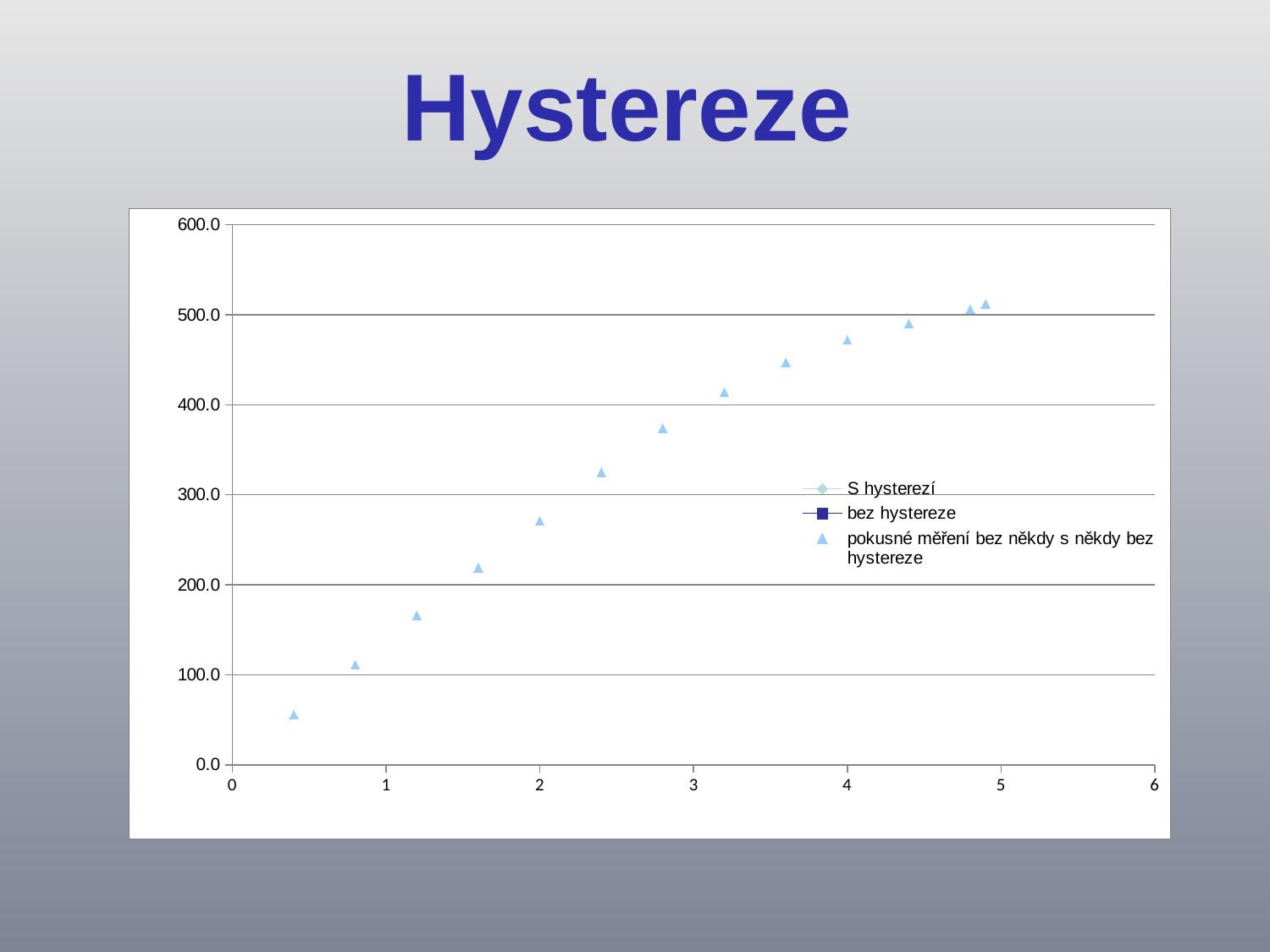
Is the plotted value at x = 1.2 greater or less than 100? greater Do the plotted values rise or fall as x increases from 0 to 5? rise What is the name of the second series listed in the legend? bez hystereze What kind of chart is shown on the slide? scatter chart Is the plotted value at x = 0.4 greater or less than 100? less Is the plotted value at x = 2.8 greater or less than 300? greater How many series does the legend list? 3 How many data points are plotted on the chart? 13 What is the title of the slide containing the chart? Hystereze